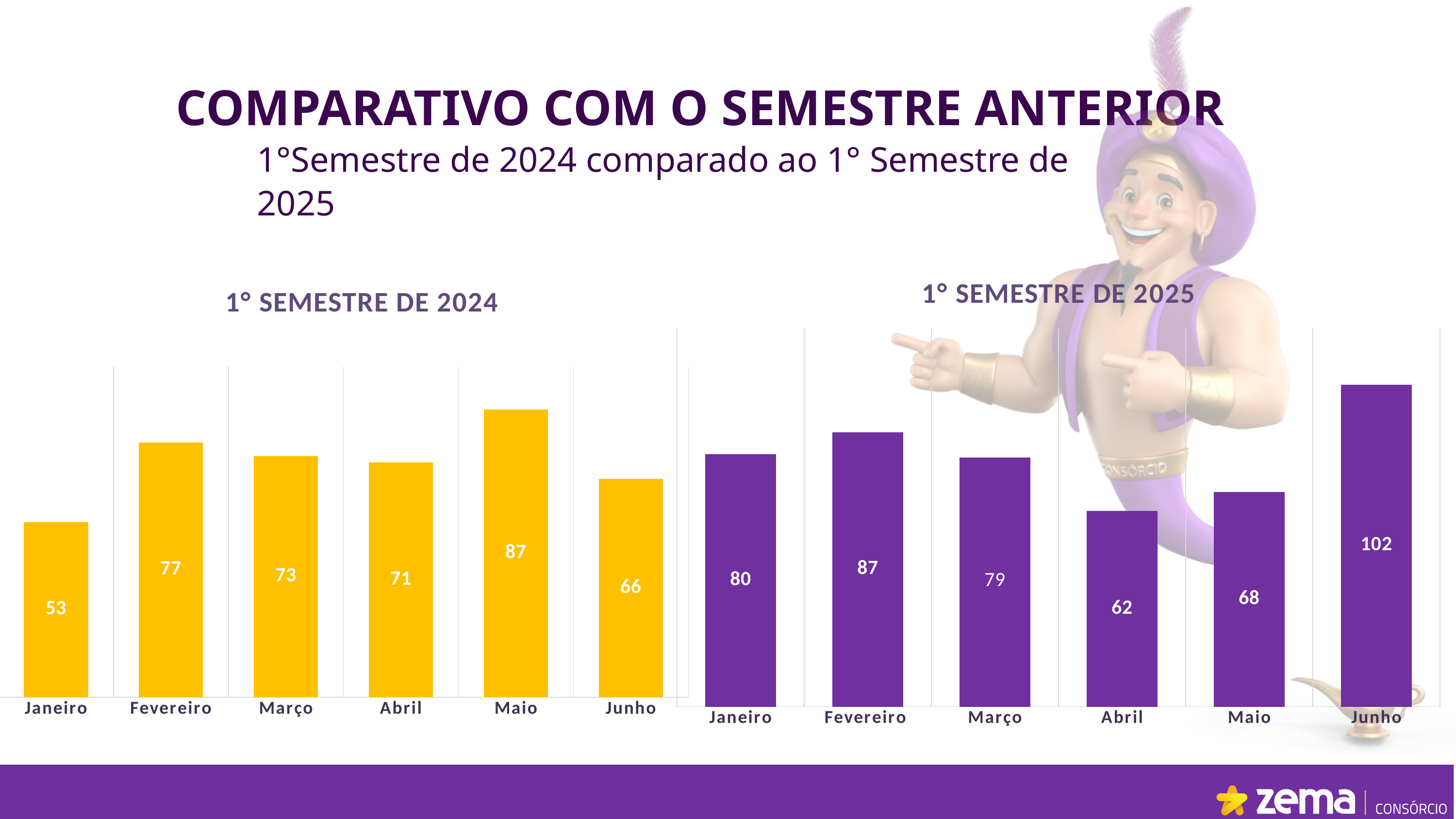
In the '1° SEMESTRE DE 2024' chart, which month has the highest value? Maio In the '1° SEMESTRE DE 2024' chart, which month has the lowest value? Janeiro In the '1° SEMESTRE DE 2025' chart, which month has the highest value? Junho How many months are shown in the '1° SEMESTRE DE 2024' chart? 6 In the '1° SEMESTRE DE 2025' chart, which is larger, the value for Fevereiro or the value for Março? Fevereiro What colour are the bars in the '1° SEMESTRE DE 2024' chart? Yellow In the '1° SEMESTRE DE 2025' chart, which month has the lowest value? Abril What kind of chart is the '1° SEMESTRE DE 2025' chart? Bar chart In the '1° SEMESTRE DE 2025' chart, what is the value for Abril? 62 In the '1° SEMESTRE DE 2024' chart, what is the value for Maio? 87 In the '1° SEMESTRE DE 2025' chart, what is the difference between the values for Junho and Janeiro? 22 In the '1° SEMESTRE DE 2024' chart, what is the difference between the values for Fevereiro and Junho? 11